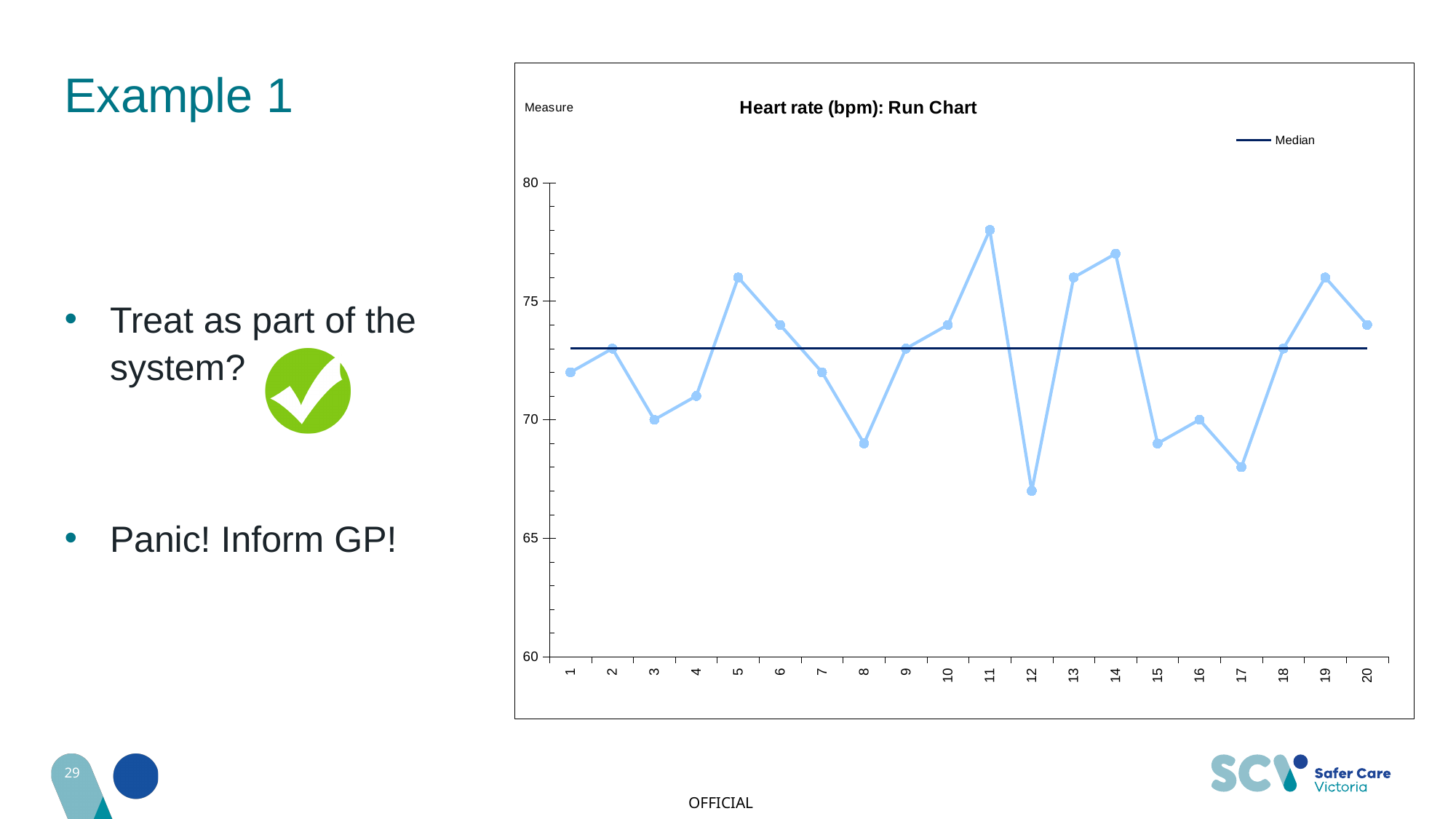
How many series does the legend list? 1 How many data points are plotted on the chart? 20 What is the title of the chart? Heart rate (bpm): Run Chart Which point has the highest heart rate? 11 Which is larger, the value at point 14 or the value at point 15? point 14 Which point has the lowest heart rate? 12 Do the values rise or fall from point 11 to point 12? fall What kind of chart is shown on the slide? line chart Is the value at point 5 greater or less than 75? greater What is the heart rate value at point 16? 70 What is the heart rate value at point 3? 70 Is the value at point 8 greater or less than 70? less